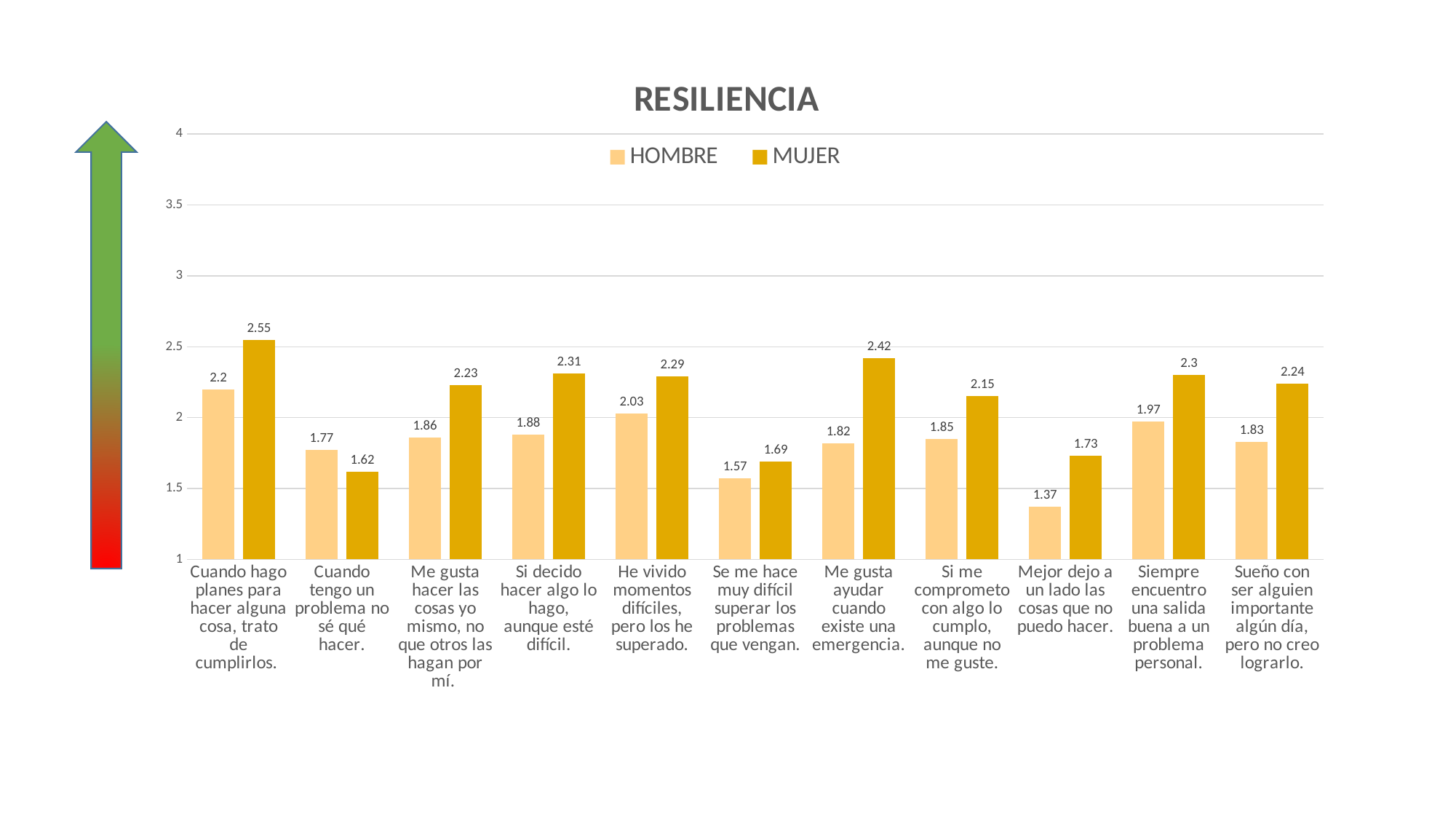
What is the title of the chart? RESILIENCIA Which category has the highest MUJER value? Cuando hago planes para hacer alguna cosa, trato de cumplirlos. What is the difference between the MUJER and HOMBRE values for "Me gusta ayudar cuando existe una emergencia."? 0.6 What is the HOMBRE value for "He vivido momentos difíciles, pero los he superado."? 2.03 For "Cuando tengo un problema no sé qué hacer.", which series has the larger value, HOMBRE or MUJER? HOMBRE Is the MUJER value for "Siempre encuentro una salida buena a un problema personal." greater or less than 2? greater What kind of chart is shown on the slide? bar chart Which category has the lowest HOMBRE value? Mejor dejo a un lado las cosas que no puedo hacer. How many categories are shown on the x axis? 11 What is the MUJER value for "Me gusta ayudar cuando existe una emergencia."? 2.42 How many series does the legend list? 2 What is the MUJER value for "Cuando tengo un problema no sé qué hacer."? 1.62